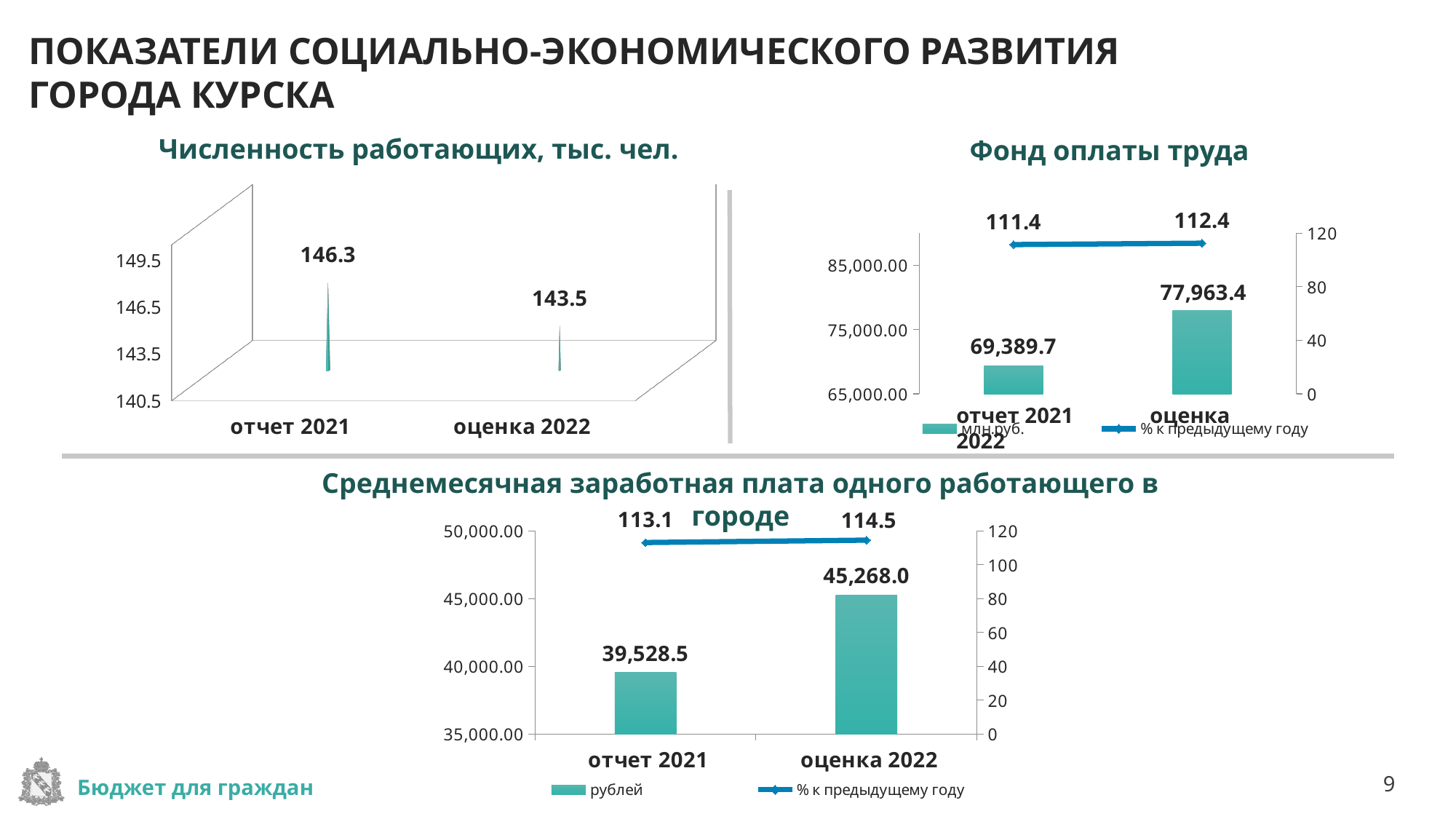
In the chart 'Среднемесячная заработная плата одного работающего в городе', what is the bar value (рублей) for 'отчет 2021'? 39,528.5 In the chart 'Фонд оплаты труда', what is the difference between the bar values for 'оценка 2022' and 'отчет 2021'? 8,573.7 In the chart 'Фонд оплаты труда', what is the bar value (млн.руб.) for 'отчет 2021'? 69,389.7 In the chart 'Фонд оплаты труда', what is the '% к предыдущему году' value for 'оценка 2022'? 112.4 In the chart 'Фонд оплаты труда', what is the bar value (млн.руб.) for 'оценка 2022'? 77,963.4 In the chart 'Численность работающих, тыс. чел.', what is the value for 'отчет 2021'? 146.3 In the chart 'Численность работающих, тыс. чел.', by how much does the value for 'отчет 2021' exceed the value for 'оценка 2022'? 2.8 In the chart 'Среднемесячная заработная плата одного работающего в городе', what is the difference between the bar values for 'оценка 2022' and 'отчет 2021'? 5,739.5 In the chart 'Среднемесячная заработная плата одного работающего в городе', which category has the higher bar value? оценка 2022 In the chart 'Численность работающих, тыс. чел.', what is the value for 'оценка 2022'? 143.5 In the chart 'Численность работающих, тыс. чел.', do the values rise or fall from 'отчет 2021' to 'оценка 2022'? fall In the chart 'Фонд оплаты труда', how many series does the legend list? 2